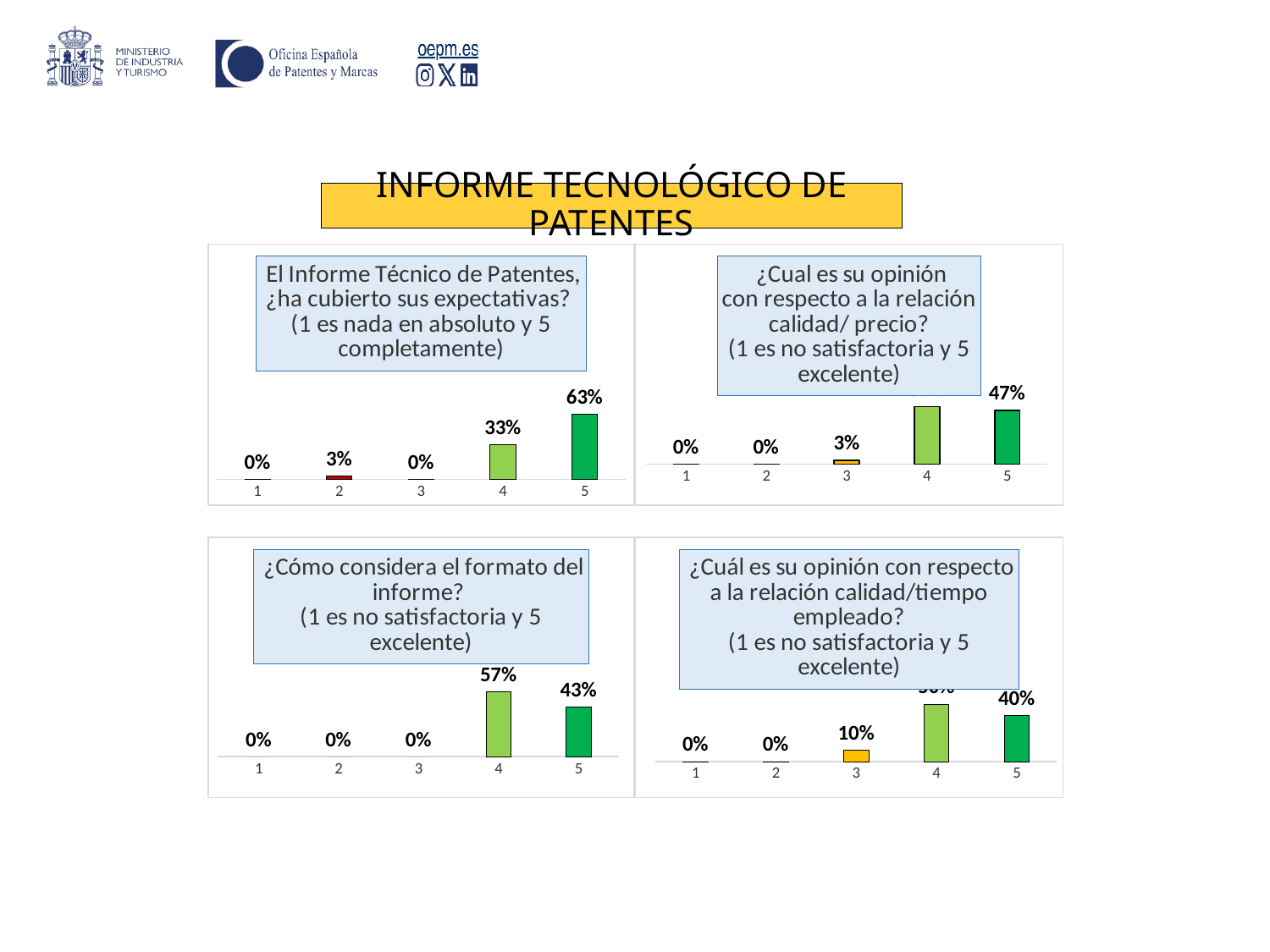
In the bottom-left chart (¿Cómo considera el formato del informe?), what is the difference between the values for categories 4 and 5? 14% In the top-right chart (relación calidad/ precio), what is the value for category 3? 3% In the bottom-right chart (relación calidad/tiempo empleado), what is the value for category 3? 10% In the bottom-right chart (relación calidad/tiempo empleado), which is larger, the value for category 3 or the value for category 5? Category 5 In the top-left chart (¿ha cubierto sus expectativas?), what is the value for category 2? 3% In the top-right chart (relación calidad/ precio), what is the value for category 5? 47% In the bottom-left chart (¿Cómo considera el formato del informe?), which category has the highest value? 4 In the bottom-left chart (¿Cómo considera el formato del informe?), what is the value for category 4? 57% In the top-left chart (¿ha cubierto sus expectativas?), what is the difference between the values for categories 5 and 4? 30% In the top-left chart (¿ha cubierto sus expectativas?), what is the value for category 4? 33% How many categories are shown on the x axis of the top-left chart (¿ha cubierto sus expectativas?)? 5 In the top-left chart (El Informe Técnico de Patentes, ¿ha cubierto sus expectativas?), what is the value for category 5? 63%